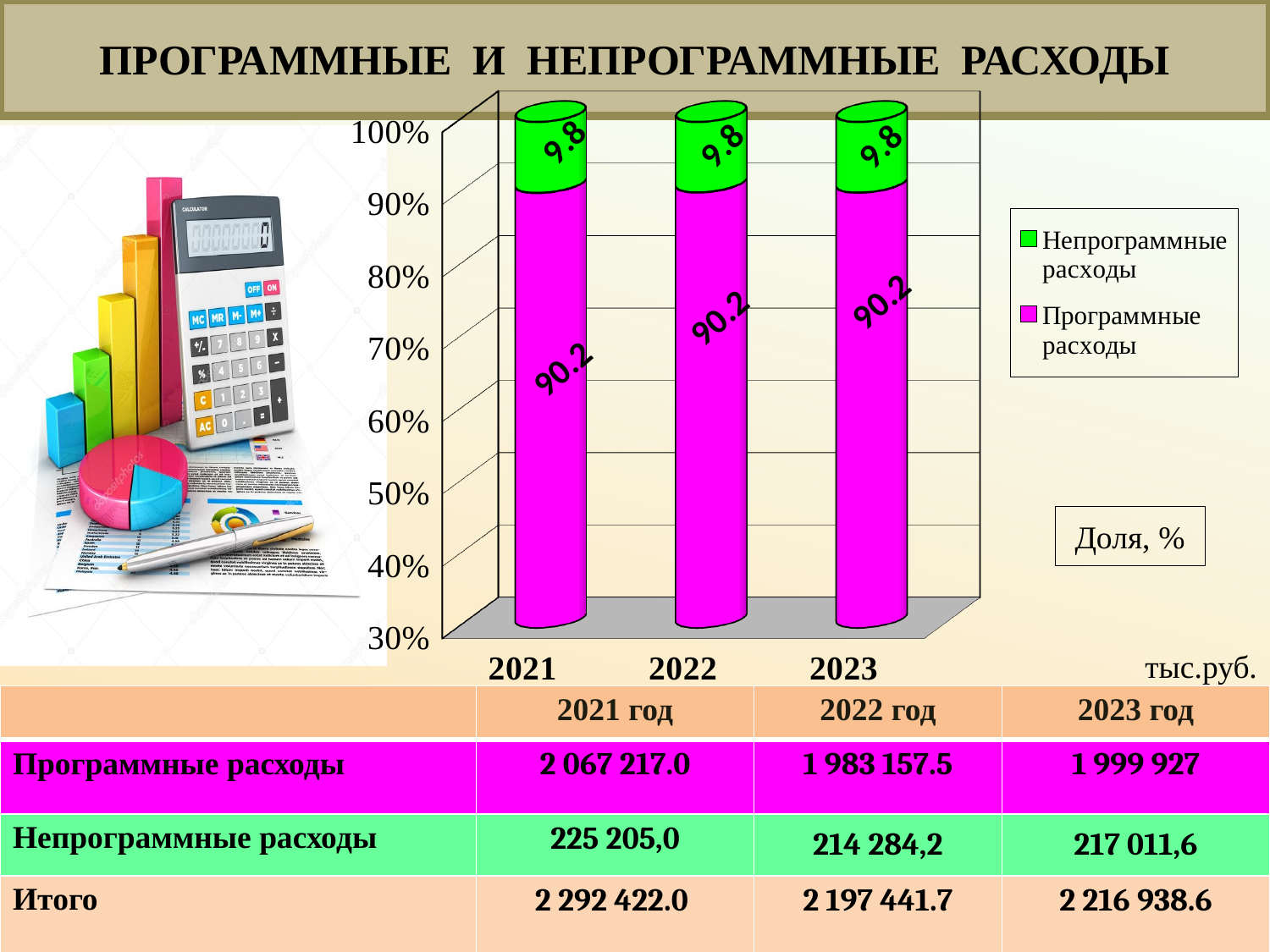
What is the difference between Программные расходы and Непрограммные расходы in 2021? 80.4 What is the title of the chart? ПРОГРАММНЫЕ И НЕПРОГРАММНЫЕ РАСХОДЫ How many years are shown on the x axis? 3 What is the value for Непрограммные расходы in 2022? 9.8 What is the value for Программные расходы in 2023? 90.2 Does the value for Программные расходы rise, fall or stay the same from 2021 to 2023? Stays the same What is the value for Непрограммные расходы in 2023? 9.8 How many series does the legend list? 2 Which colour represents Непрограммные расходы in the legend? Green What kind of chart is shown? Stacked bar chart What is the value for Программные расходы in 2021? 90.2 Which is larger in 2022, Программные расходы or Непрограммные расходы? Программные расходы